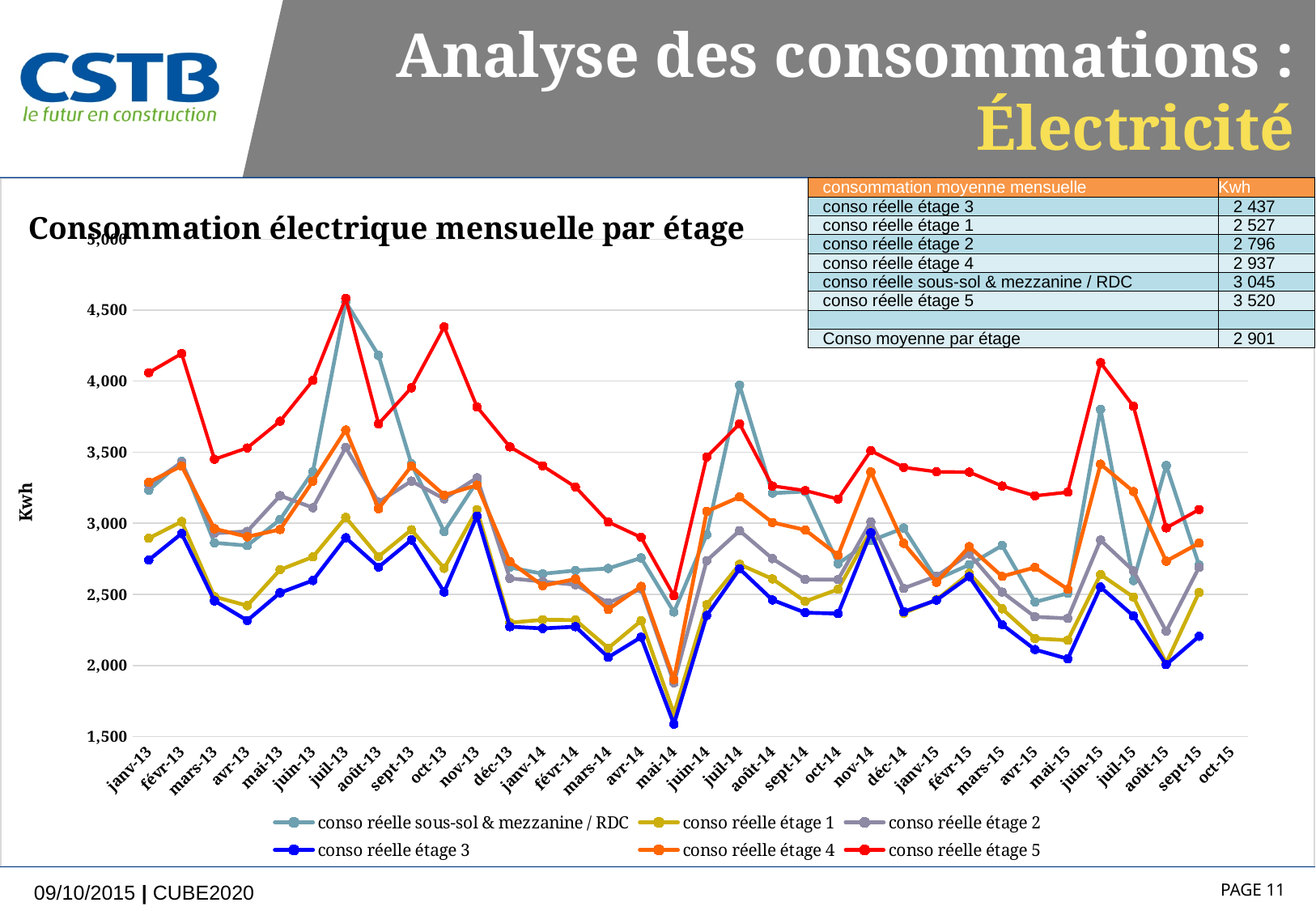
Which series has the highest value in janv-13? conso réelle étage 5 How many months are shown along the x axis of the chart? 34 Which series has the lowest value in mai-14? conso réelle étage 3 Is the value for conso réelle étage 3 in mai-14 greater or less than 2,000? less Does the value for conso réelle étage 5 rise or fall from oct-13 to mai-14? fall Is the value for conso réelle étage 5 in juil-13 greater or less than 4,500? greater What label is shown on the y axis of the chart? Kwh What kind of chart is shown on the slide? line chart How many series does the chart legend list? 6 Is the value for conso réelle étage 5 in juin-15 greater or less than 4,000? greater What is the title of the chart? Consommation électrique mensuelle par étage